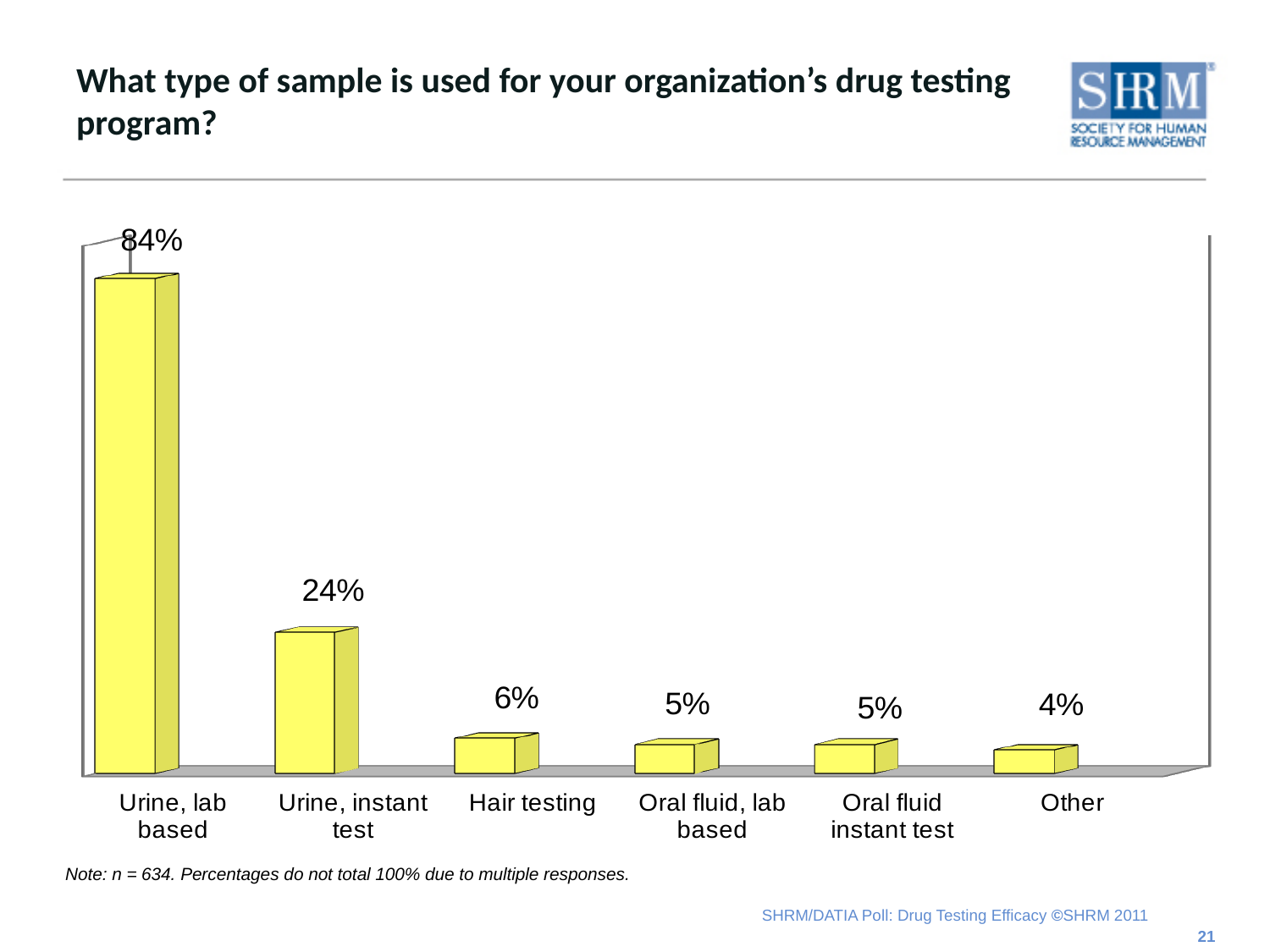
Do the values rise or fall moving from left to right across the categories? Fall What kind of chart is shown on the slide? Bar chart How many sample type categories are shown on the chart? 6 Which sample type has the lowest percentage? Other What is the value shown for Urine, instant test? 24% What is the difference between the values for Urine, lab based and Urine, instant test? 60 percentage points What is the sample size (n) given in the note below the chart? 634 What percentage of organizations use urine, lab based samples for drug testing? 84% Which is larger, the value for Hair testing or the value for Other? Hair testing What is the value shown for Other? 4% What is the value shown for Hair testing? 6% Which sample type has the highest percentage? Urine, lab based